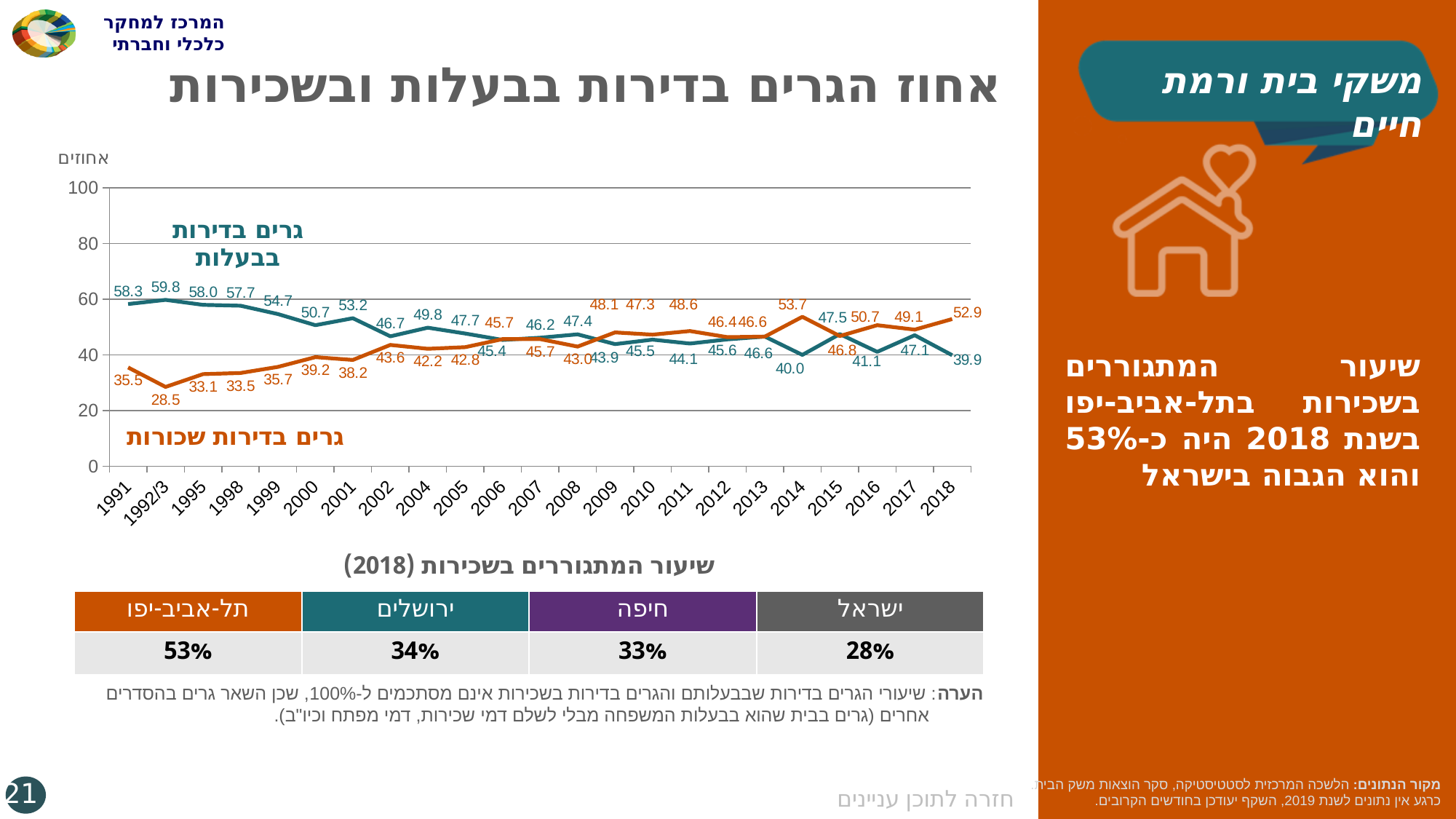
Is the value for גרים בדירות בבעלות in 2018 greater or less than 40? less How many years are shown on the x axis of the line chart? 23 What type of chart is shown on the slide? line chart In which year is the value for גרים בדירות בבעלות highest? 1992/3 How many series does the line chart show? 2 In which year is the value for גרים בדירות שכורות lowest? 1992/3 What is the value for גרים בדירות שכורות in 2014? 53.7 What is the difference between גרים בדירות בבעלות and גרים בדירות שכורות in 1991? 22.8 What is the value for גרים בדירות שכורות in 2018? 52.9 Does the value for גרים בדירות שכורות generally rise or fall from 1991 to 2018? rise Which series has the larger value in 2018, גרים בדירות בבעלות or גרים בדירות שכורות? גרים בדירות שכורות What is the value for גרים בדירות בבעלות in 1991? 58.3